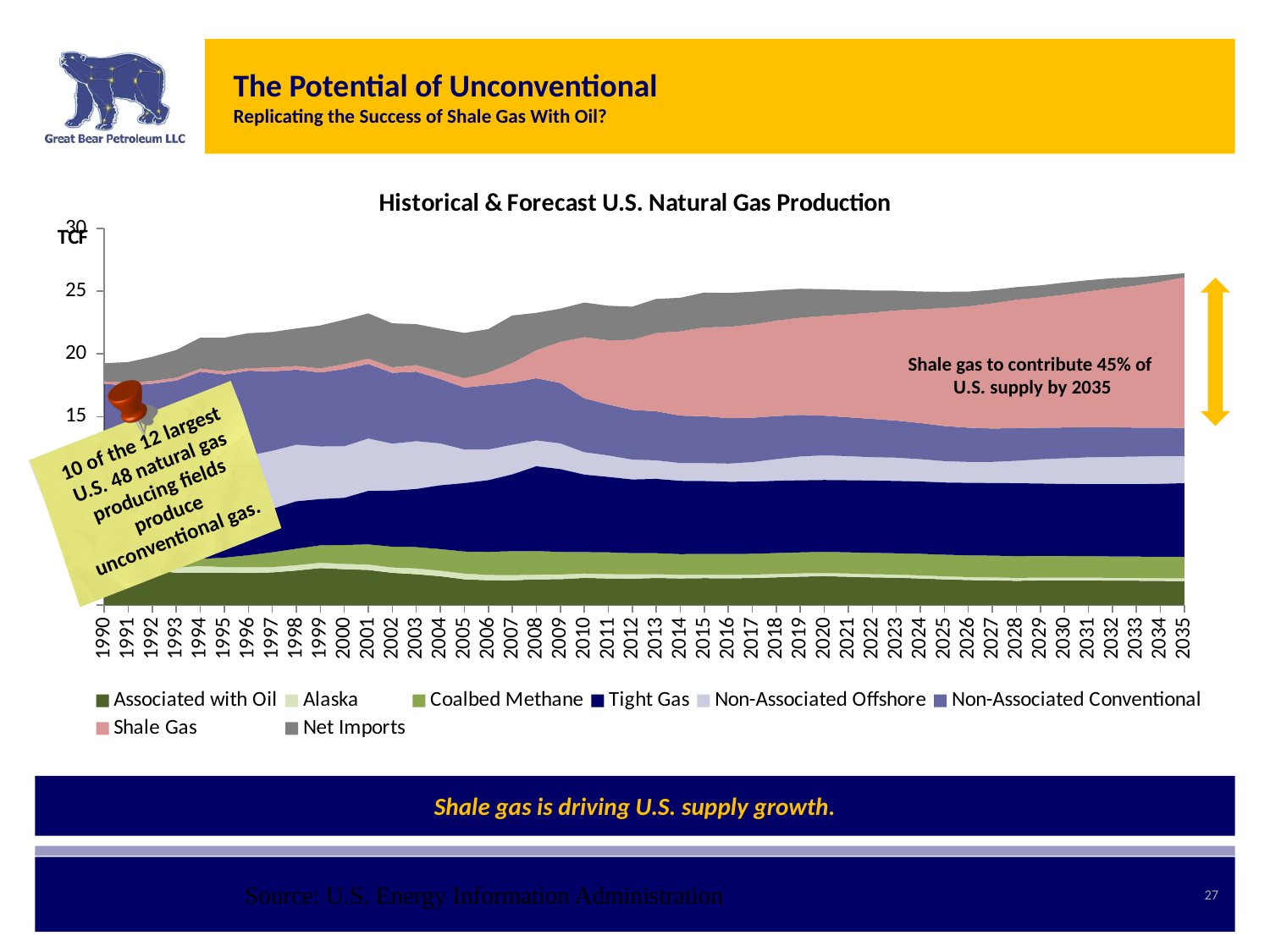
How many years are shown along the x axis? 46 Is the total U.S. natural gas production in 1990 greater or less than 20? less Is the total U.S. natural gas production in 2020 greater or less than 20? greater Is the total U.S. natural gas production in 2035 greater or less than 25? greater Does the Non-Associated Conventional series rise or fall between 2008 and 2035? fall What is the title of the chart? Historical & Forecast U.S. Natural Gas Production Does the Shale Gas series rise or fall between 2010 and 2035? rise What kind of chart is shown on the slide? Stacked area chart What unit is shown on the vertical axis of the chart? TCF Which year has the larger total production, 1990 or 2035? 2035 How many series does the legend list? 8